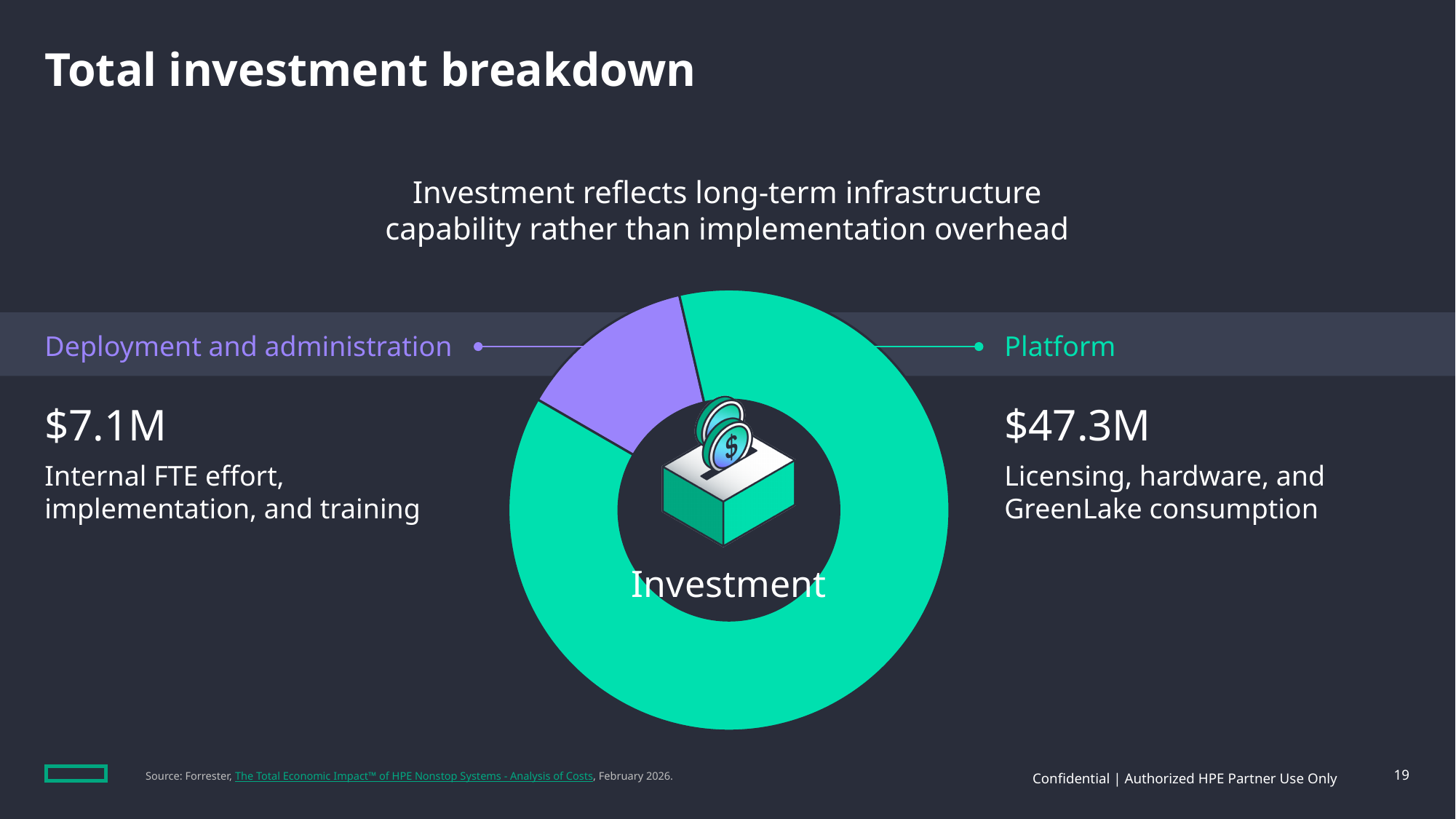
What kind of chart is shown on the slide? Donut chart Which segment of the donut chart is the largest? Platform What colour is the Platform segment of the donut chart? Green Which is larger, the Platform value or the Deployment and administration value? Platform What label appears in the centre of the donut chart? Investment Which segment of the donut chart is the smallest? Deployment and administration What is the total of the two segments in the donut chart? $54.4M What is the value for Platform in the donut chart? $47.3M How many segments does the donut chart have? 2 What is the value for Deployment and administration in the donut chart? $7.1M What is the difference between the Platform value and the Deployment and administration value? $40.2M